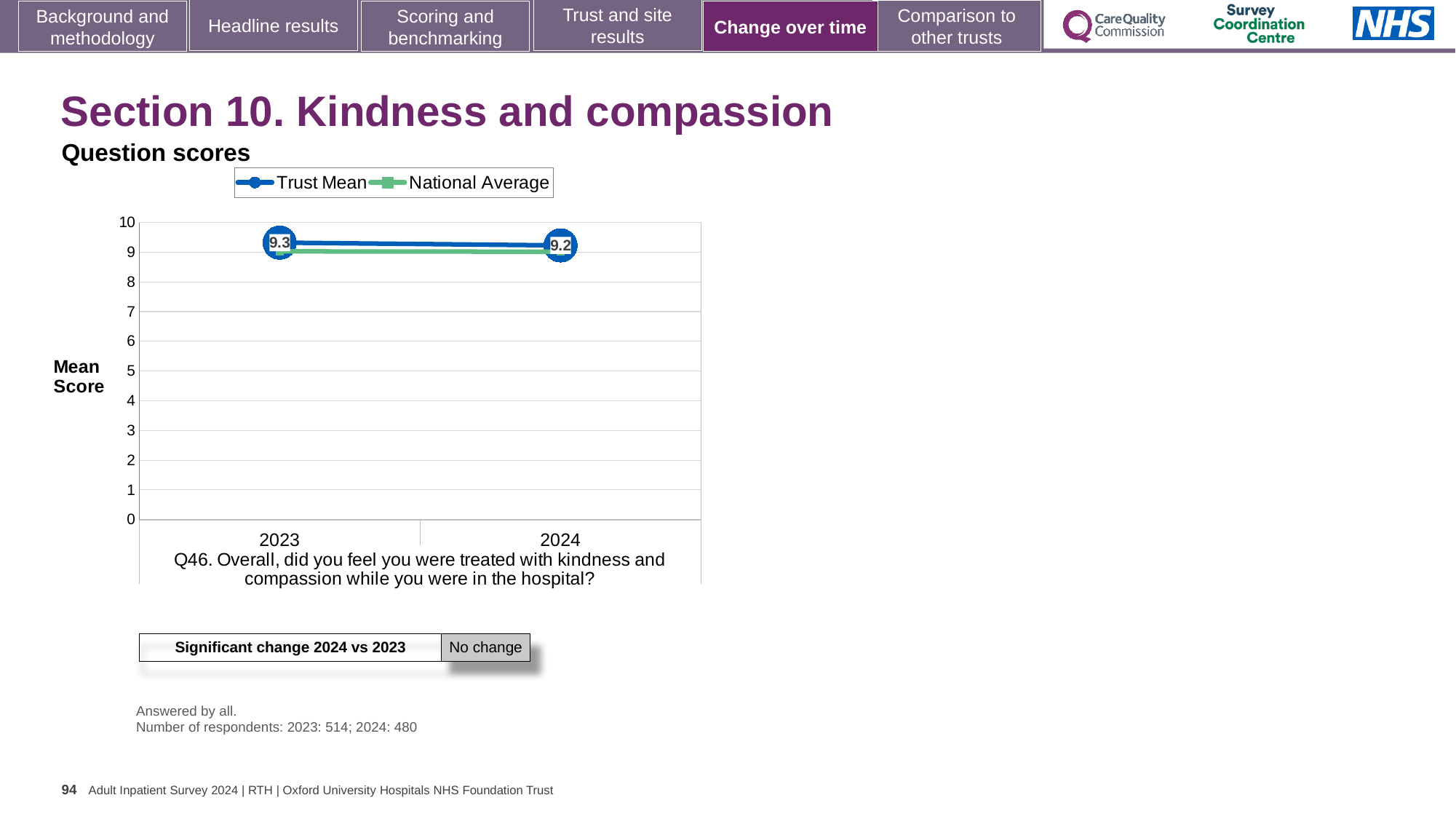
Is the National Average value for 2024 greater or less than 5? greater What is the label on the y axis of the chart? Mean Score Which year has the higher Trust Mean score, 2023 or 2024? 2023 In which year is the Trust Mean at its lowest? 2024 What is the Trust Mean score for 2024? 9.2 By how much did the Trust Mean change from 2023 to 2024? 0.1 How many years are plotted on the x axis? 2 Is the National Average value for 2023 greater or less than 8? greater What kind of chart is shown on the slide? line chart Does the Trust Mean rise or fall from 2023 to 2024? fall How many series does the legend list? 2 What is the Trust Mean score for 2023? 9.3